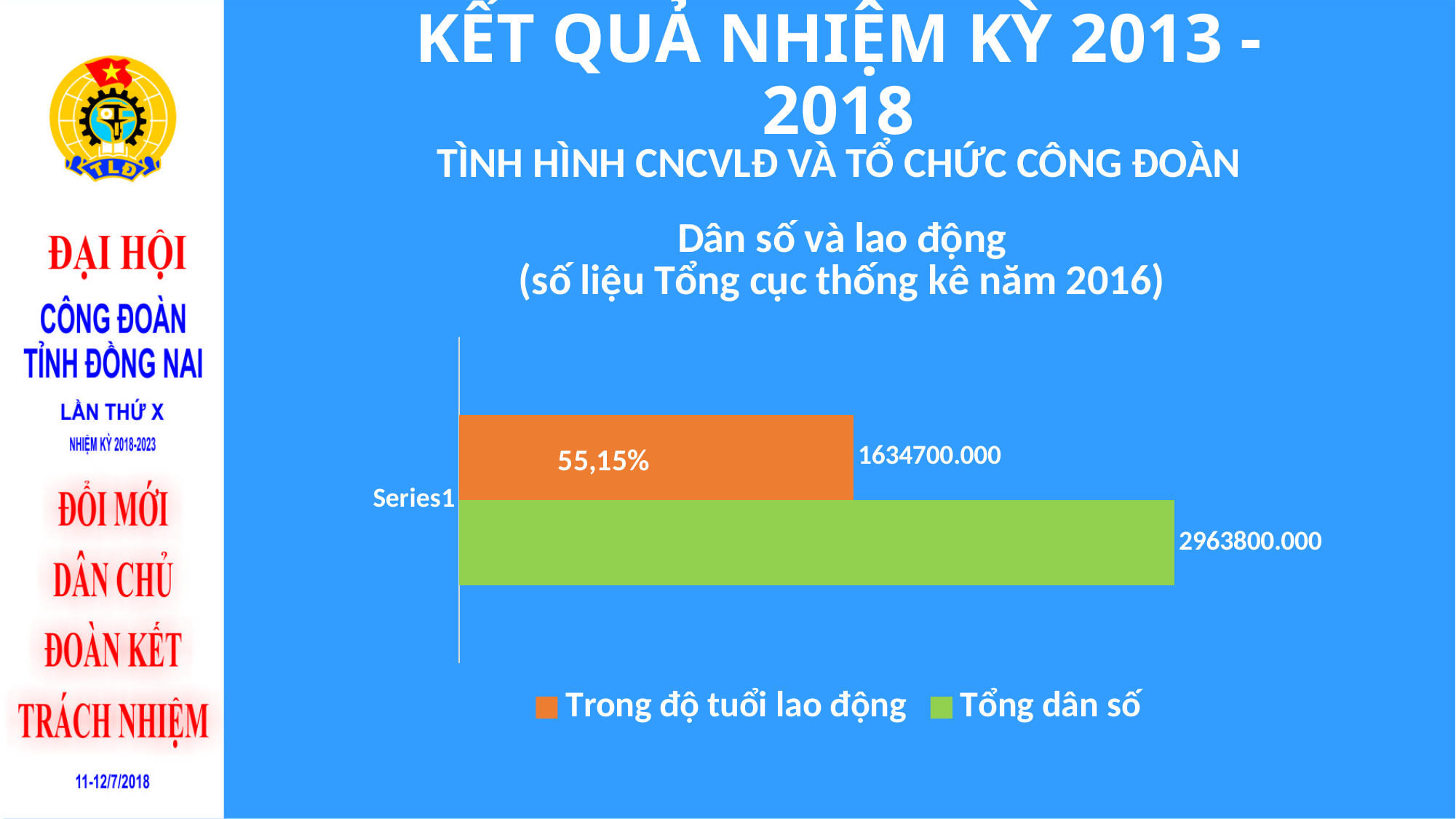
Which series has the higher value, Trong độ tuổi lao động or Tổng dân số? Tổng dân số What is the difference between the value for Tổng dân số and the value for Trong độ tuổi lao động? 1329100.000 Which series has the highest value? Tổng dân số Which series has the lowest value? Trong độ tuổi lao động How many categories are shown on the vertical axis of the chart? 1 What percentage label is printed on the orange bar? 55,15% How many series does the legend list? 2 What is the value for Tổng dân số? 2963800.000 What is the value for Trong độ tuổi lao động? 1634700.000 What colour is the bar for Tổng dân số? Green What kind of chart is shown on the slide? Bar chart What is the title of the chart? Dân số và lao động (số liệu Tổng cục thống kê năm 2016)